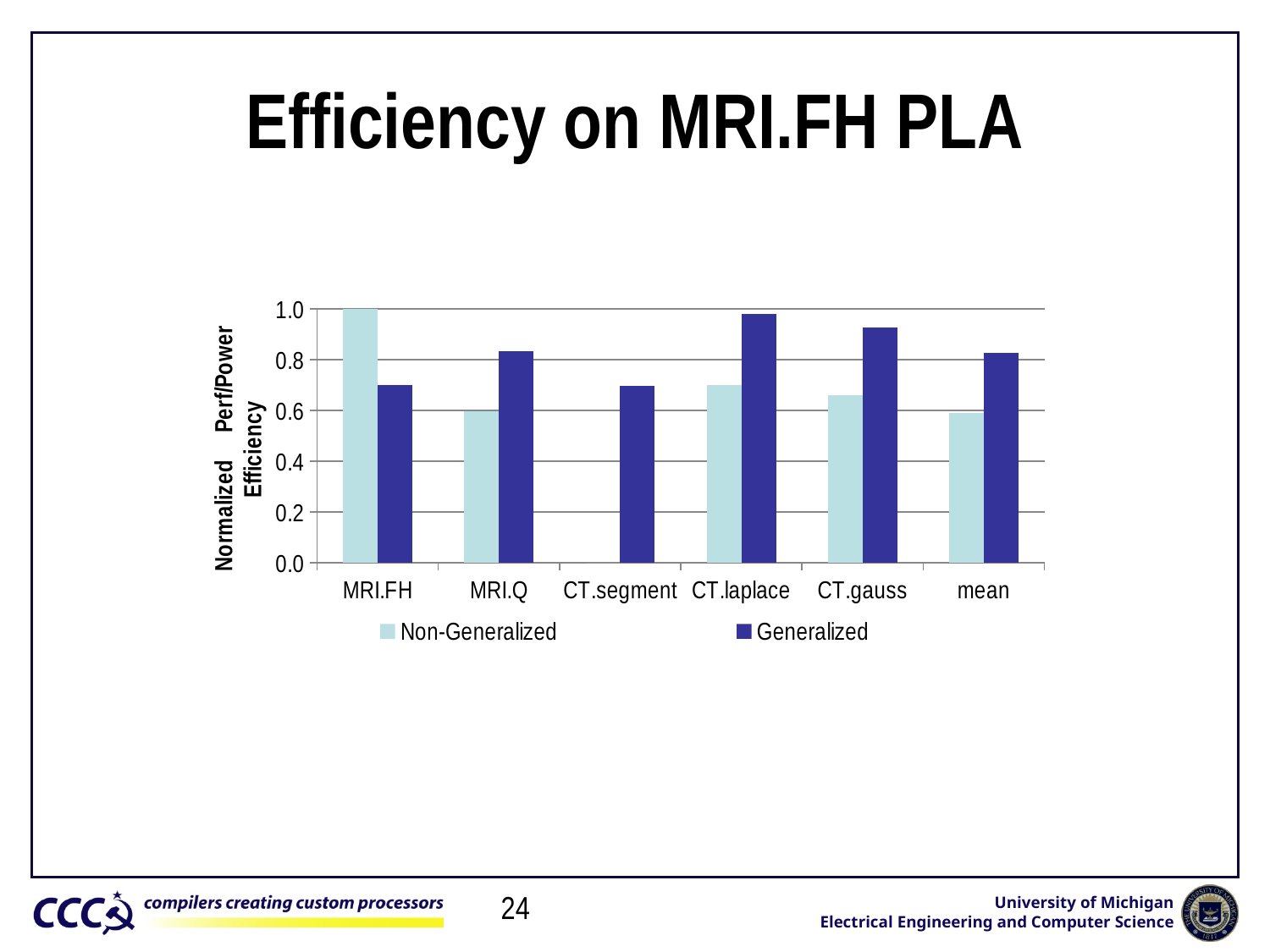
What is the title of the chart on the slide? Efficiency on MRI.FH PLA Which category has the highest Non-Generalized value? MRI.FH How many series does the legend list? 2 Which category has the highest Generalized value? CT.laplace For MRI.FH, which is larger: the Non-Generalized or the Generalized value? Non-Generalized Is the Generalized value for CT.laplace greater or less than 0.8? greater For CT.laplace, which is larger: the Non-Generalized or the Generalized value? Generalized Is the Non-Generalized value for CT.gauss greater or less than 0.8? less What kind of chart is shown on the slide? bar chart How many categories are shown on the x axis? 6 What is the Non-Generalized value for MRI.FH? 1.0